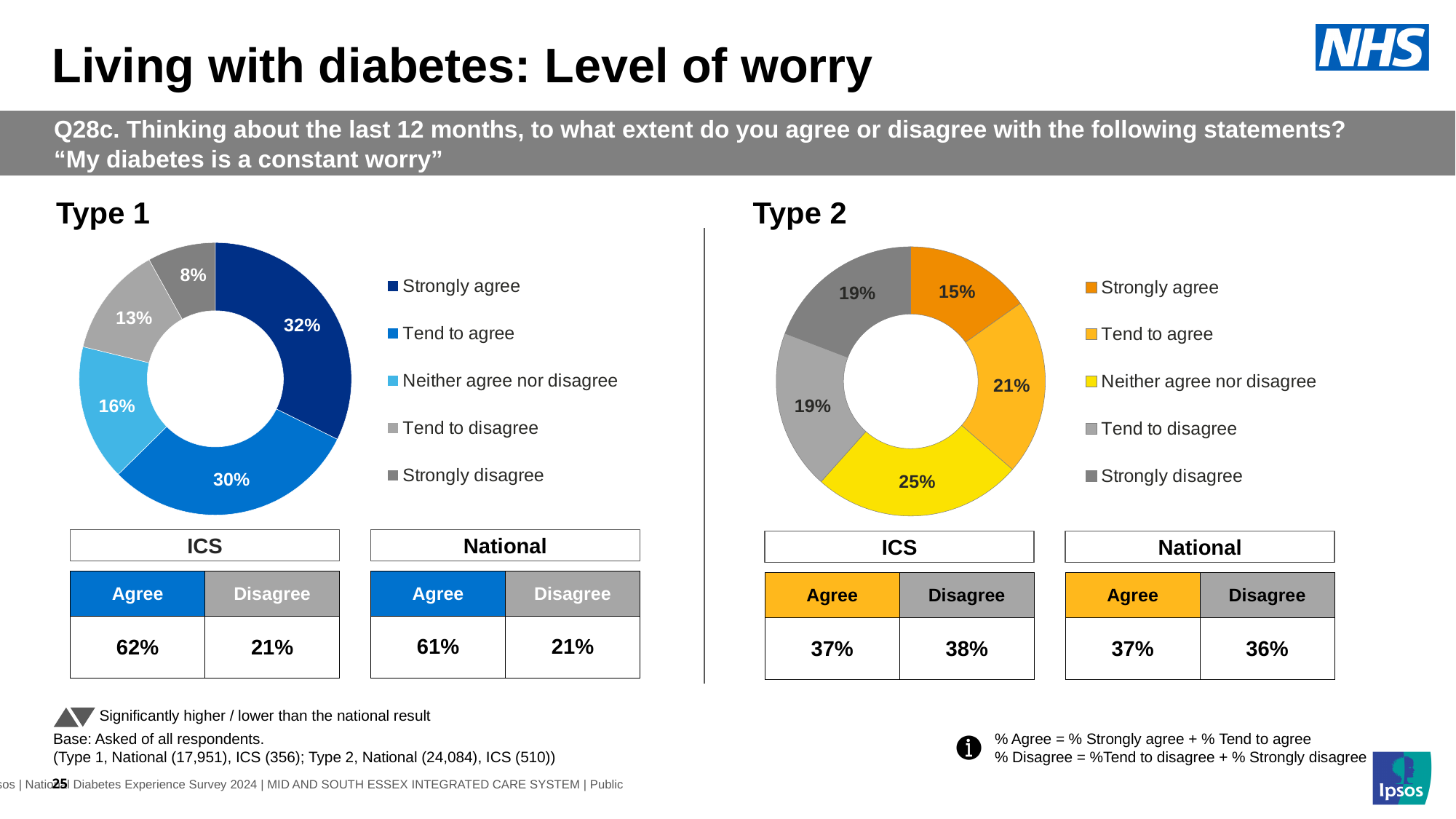
In the Type 1 chart, which response category has the smallest share? Strongly disagree In the Type 2 chart, what percentage of respondents neither agree nor disagree? 25% What kind of chart is used for Type 1? Donut (pie) chart In the Type 1 chart, what is the difference between the Strongly agree and Strongly disagree shares? 24 percentage points How many response categories does the Type 2 chart show? 5 In the Type 2 chart, what colour represents Neither agree nor disagree? Yellow In the Type 1 chart, which response category has the largest share? Strongly agree In the Type 2 chart, what percentage of respondents strongly agree? 15% In the Type 1 chart, what percentage of respondents strongly agree? 32% In the Type 2 chart, which response category has the largest share? Neither agree nor disagree In the Type 2 chart, which is larger: Tend to agree or Strongly agree? Tend to agree In the Type 1 chart, what percentage of respondents tend to disagree? 13%